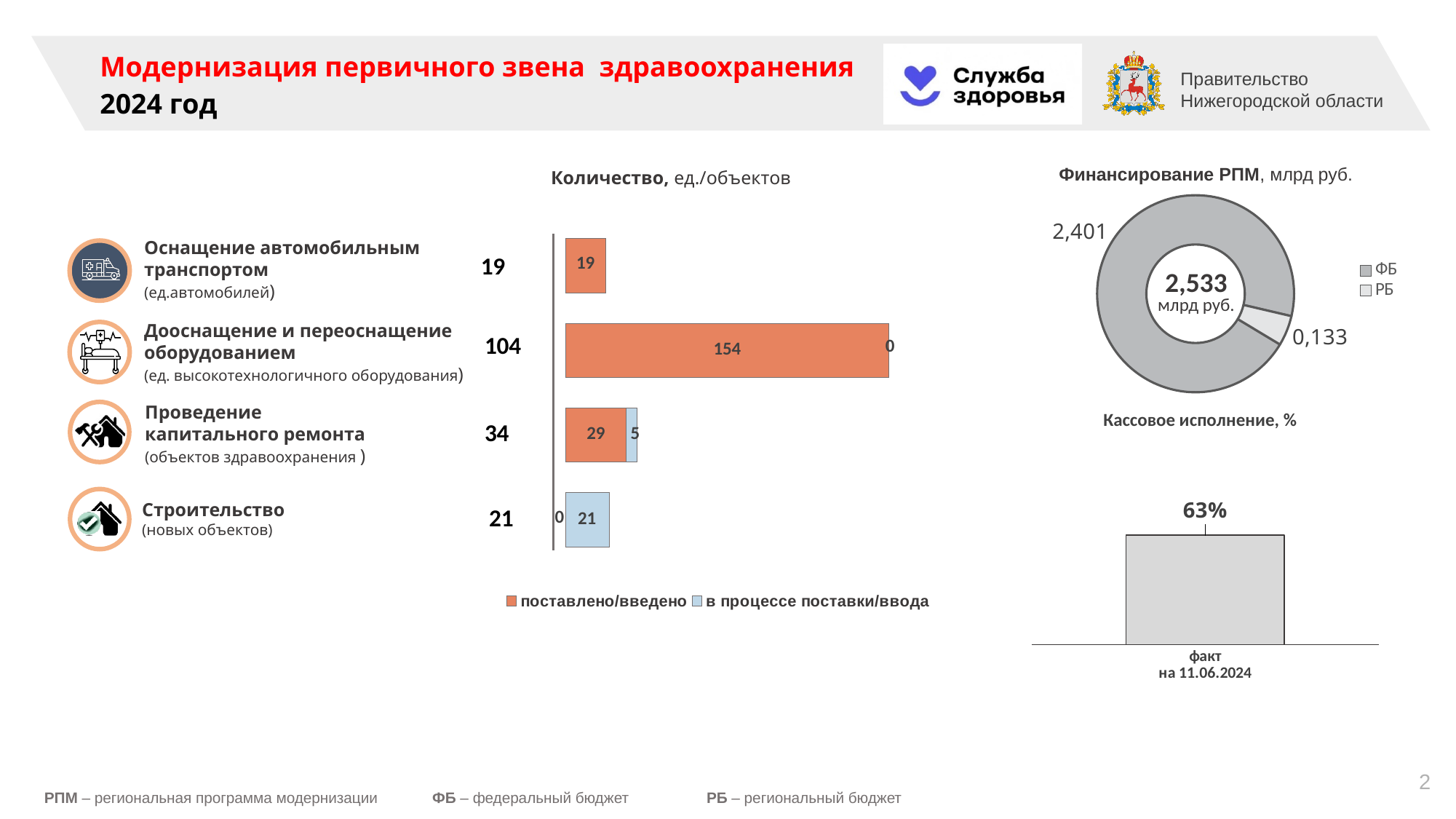
In the chart titled "Финансирование РПМ, млрд руб.", what is the value for РБ? 0,133 In the chart titled "Финансирование РПМ, млрд руб.", what is the value for ФБ? 2,401 In the chart titled "Количество, ед./объектов", how many series does the legend list? 2 What kind of chart is the one titled "Количество, ед./объектов"? Bar chart In the chart titled "Количество, ед./объектов", which category has the highest "поставлено/введено" value? Дооснащение и переоснащение оборудованием In the chart titled "Кассовое исполнение, %", what is the value for "факт на 11.06.2024"? 63% In the chart titled "Количество, ед./объектов", what is the total of the stacked bar for "Проведение капитального ремонта"? 34 In the chart titled "Количество, ед./объектов", what is the value of "поставлено/введено" for "Проведение капитального ремонта"? 29 In the chart titled "Количество, ед./объектов", how many categories are plotted? 4 In the chart titled "Финансирование РПМ, млрд руб.", which segment is larger, ФБ or РБ? ФБ In the chart titled "Количество, ед./объектов", what is the value of "поставлено/введено" for "Дооснащение и переоснащение оборудованием"? 154 In the chart titled "Количество, ед./объектов", what is the value of "в процессе поставки/ввода" for "Строительство"? 21